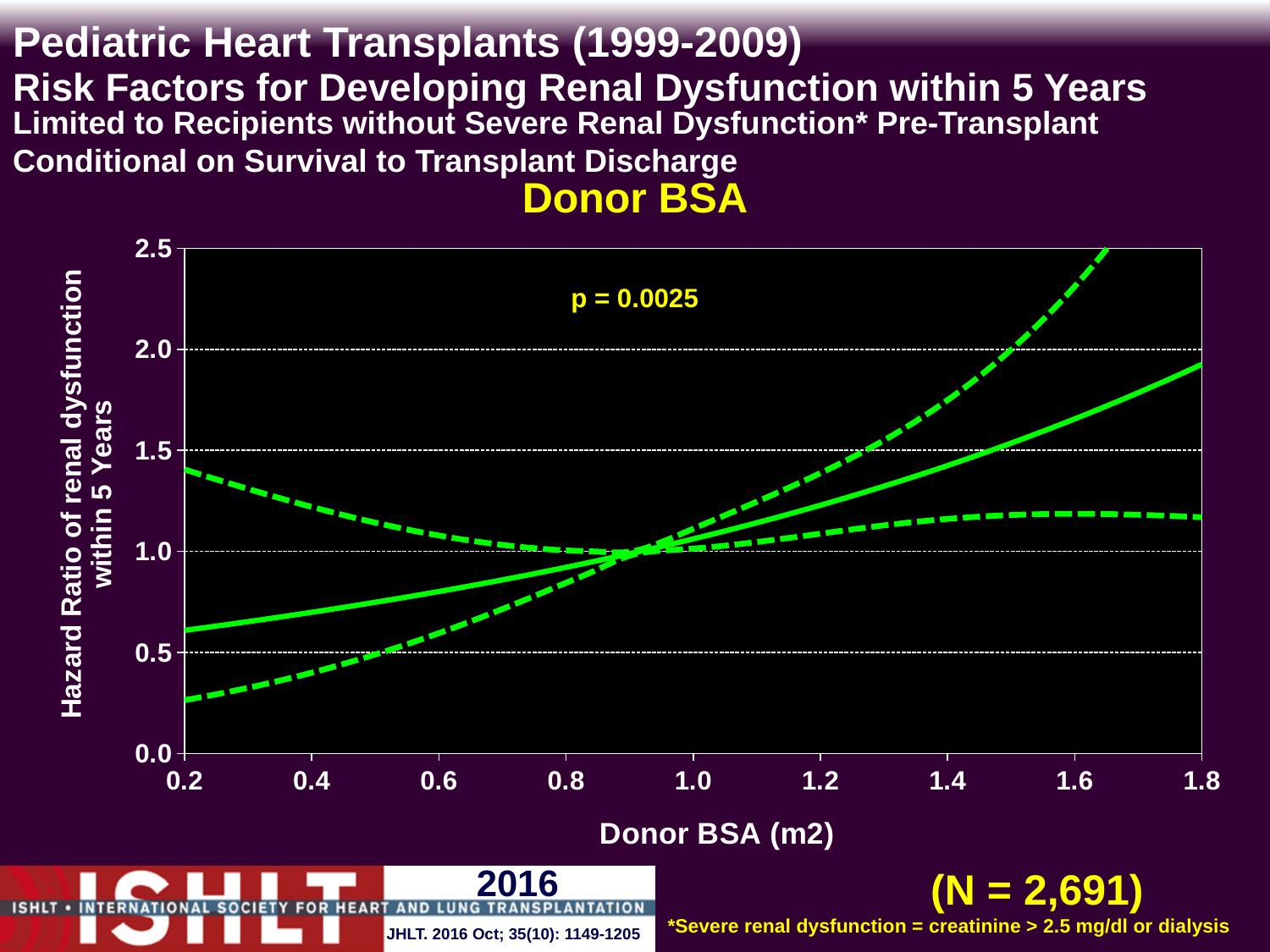
Is the value of the solid line at Donor BSA 1.2 greater or less than 1.0? greater What p-value is printed on the chart? p = 0.0025 How many lines are plotted on the chart? 3 Does the solid line rise or fall as Donor BSA increases from 0.2 to 1.8? rise What kind of chart is shown on the slide? line chart What is the label of the x axis of the chart? Donor BSA (m2) Is the value of the solid line at Donor BSA 1.8 greater or less than 1.5? greater Does the upper dashed line rise or fall as Donor BSA increases from 0.2 to 0.8? fall Is the value of the lower dashed line at Donor BSA 0.2 greater or less than 0.5? less